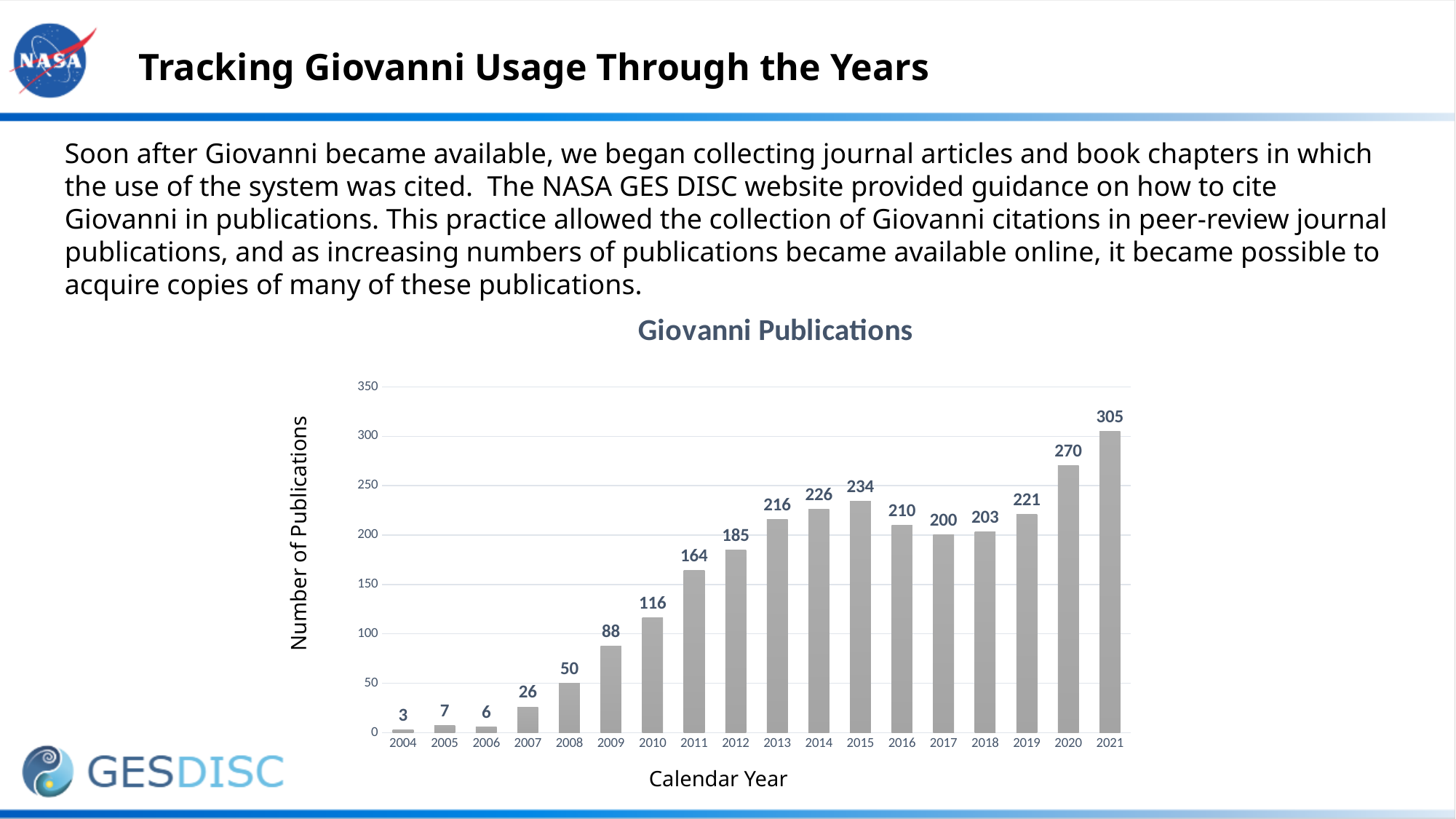
What is the label of the y axis? Number of Publications Which year has the highest number of publications? 2021 Which year has the lowest number of publications? 2004 Is the value for 2011 greater or less than 150? greater What is the number of publications for 2012? 185 Do the values generally rise or fall from 2004 to 2021? rise What is the number of publications for 2008? 50 What is the title of the chart? Giovanni Publications Which year has more publications, 2015 or 2016? 2015 How many years are shown on the x axis? 18 What kind of chart is shown on the slide? bar chart What is the difference in publications between 2021 and 2020? 35